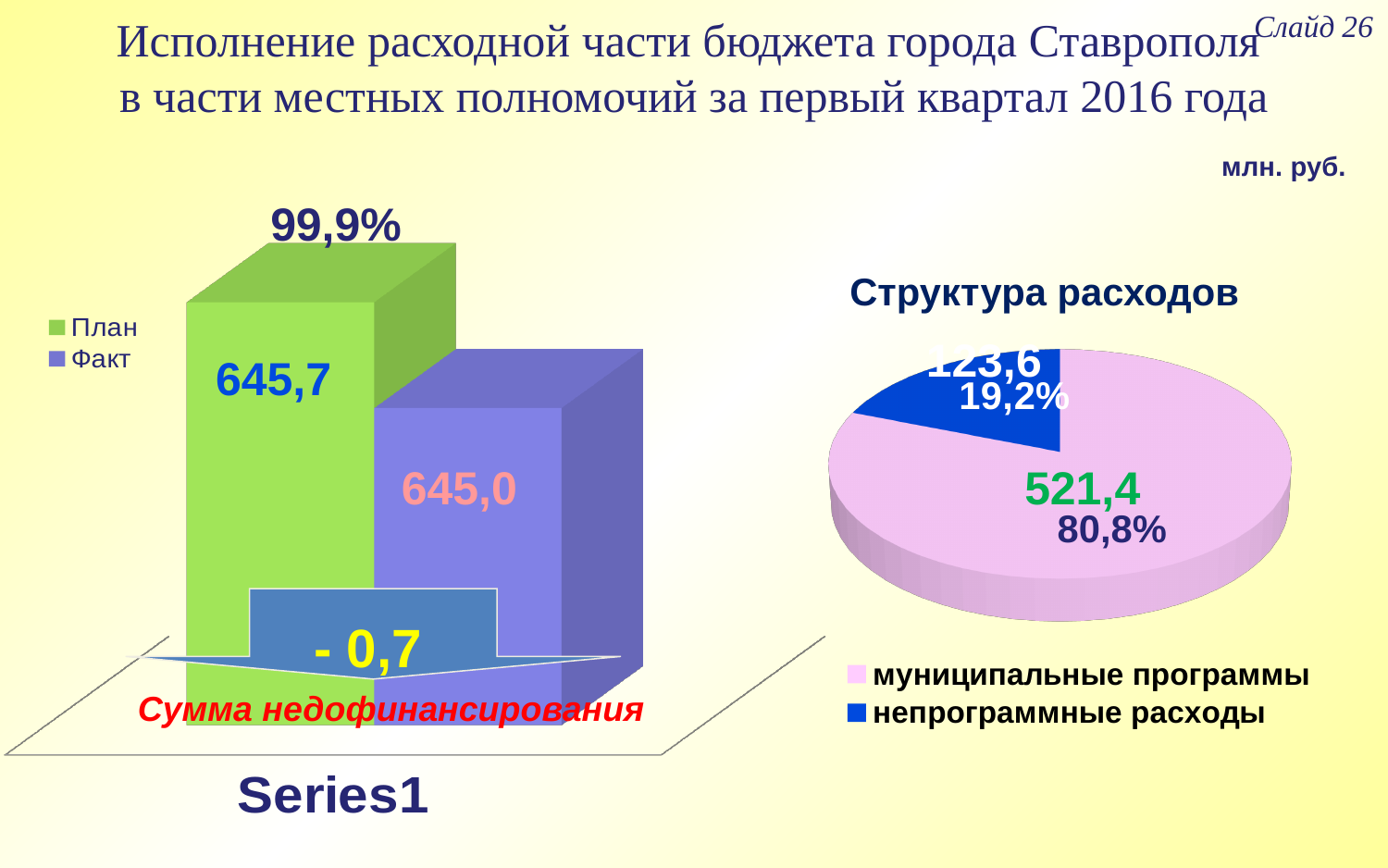
In the bar chart on the left, what is the value for План? 645,7 In the chart titled 'Структура расходов', what share of the pie is непрограммные расходы? 19,2% In the chart titled 'Структура расходов', how many slices does the pie have? 2 In the bar chart on the left, which is larger, План or Факт? План In the bar chart on the left, how many series does the legend list? 2 In the bar chart on the left, what is the difference between План and Факт? 0,7 What kind of chart is the chart on the left? bar chart In the chart titled 'Структура расходов', which category is the largest? муниципальные программы In the bar chart on the left, what is the value for Факт? 645,0 What kind of chart is the chart titled 'Структура расходов'? pie chart In the bar chart on the left, what percentage is shown above the План bar? 99,9% In the chart titled 'Структура расходов', what is the value for муниципальные программы? 521,4